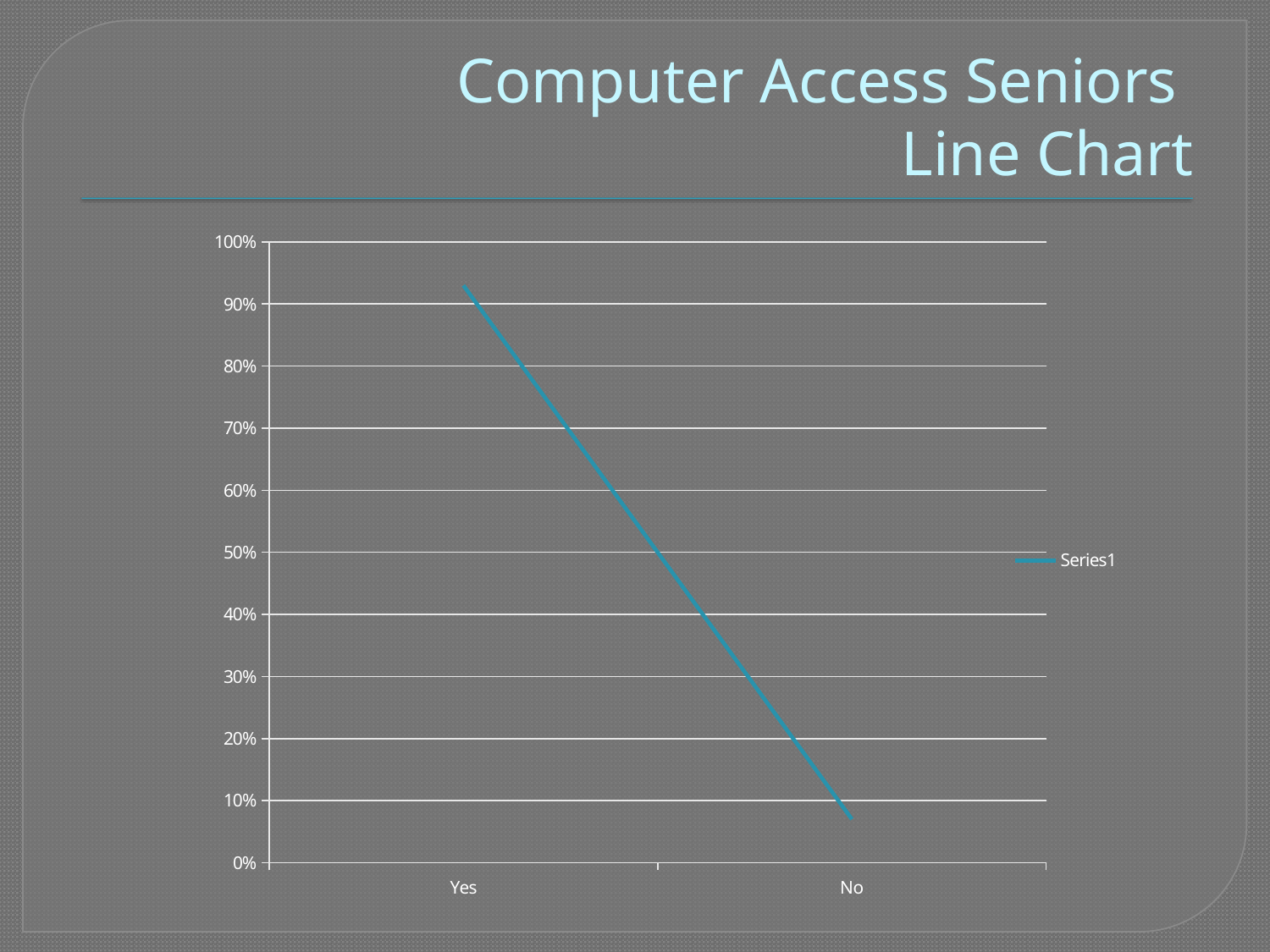
How many series does the legend list? 1 Which category has the highest value? Yes Do the values rise or fall from Yes to No along the x axis? fall Is the value for No greater or less than 20%? less Which category has the lowest value? No What is the name of the series shown in the legend? Series1 Is the value for Yes greater or less than 80%? greater How many categories are plotted on the x axis? 2 What is the title shown on the slide above the chart? Computer Access Seniors Line Chart Which is larger, the value for Yes or the value for No? Yes What kind of chart is shown on the slide? line chart